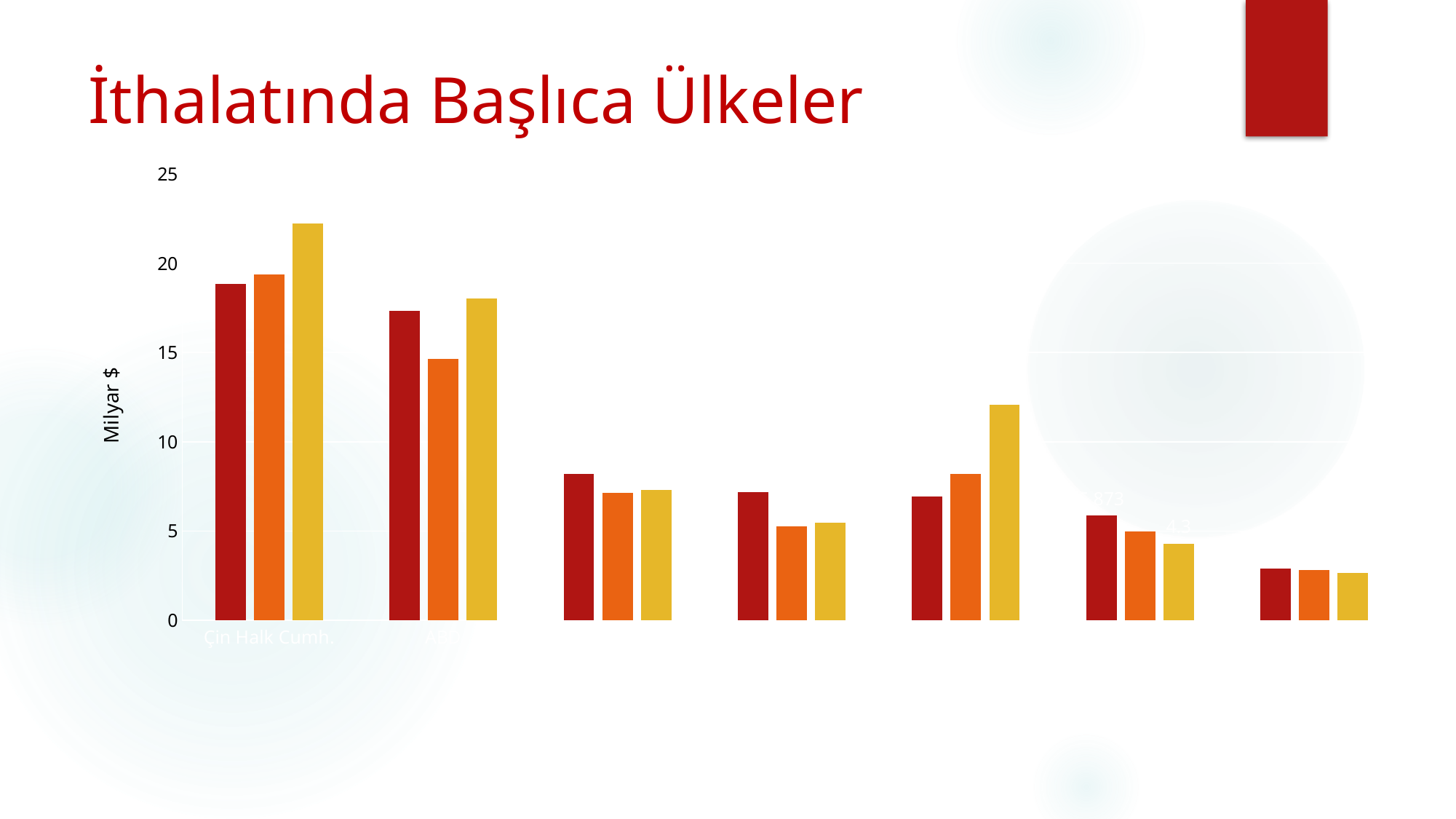
Do the bar heights generally rise or fall moving from left to right across the categories? fall For Çin Halk Cumh., which is taller: the dark red bar or the yellow bar? the yellow bar Which category has the tallest bar in the chart? Çin Halk Cumh. What is the title of the slide containing the chart? İthalatında Başlıca Ülkeler What kind of chart is shown on the slide? Bar chart How many bars are shown for each category in the chart? 3 Is the tallest (yellow) bar for Çin Halk Cumh. greater or less than 20? greater Is the dark red bar for Çin Halk Cumh. greater or less than 15? greater What is the highest value shown on the vertical axis of the chart? 25 How many groups of bars (categories) are plotted in the chart? 7 What is the label on the vertical axis of the chart? Milyar $